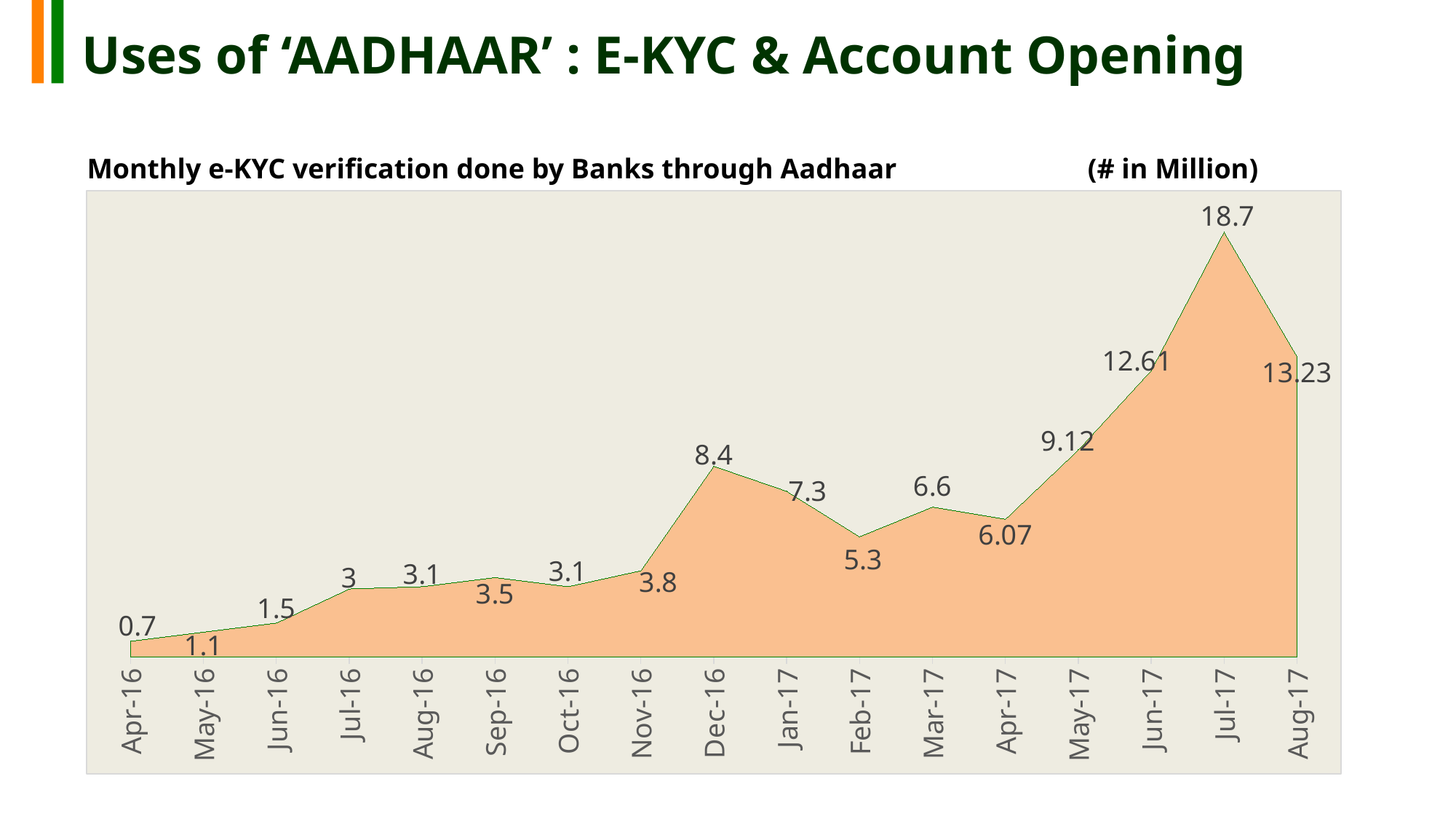
What is the value for Aug-17? 13.23 How many months are plotted on the chart? 17 Which month has the lowest value? Apr-16 What is the value for Apr-16? 0.7 What is the value for Jul-17? 18.7 What kind of chart is shown on the slide? Area chart What is the difference between the values for Dec-16 and Nov-16? 4.6 Which is larger, the value for Jan-17 or the value for Mar-17? Jan-17 What unit is stated for the values in the chart? # in Million What is the value for Dec-16? 8.4 What is the difference between the values for Jul-17 and Aug-17? 5.47 Which month has the highest value? Jul-17